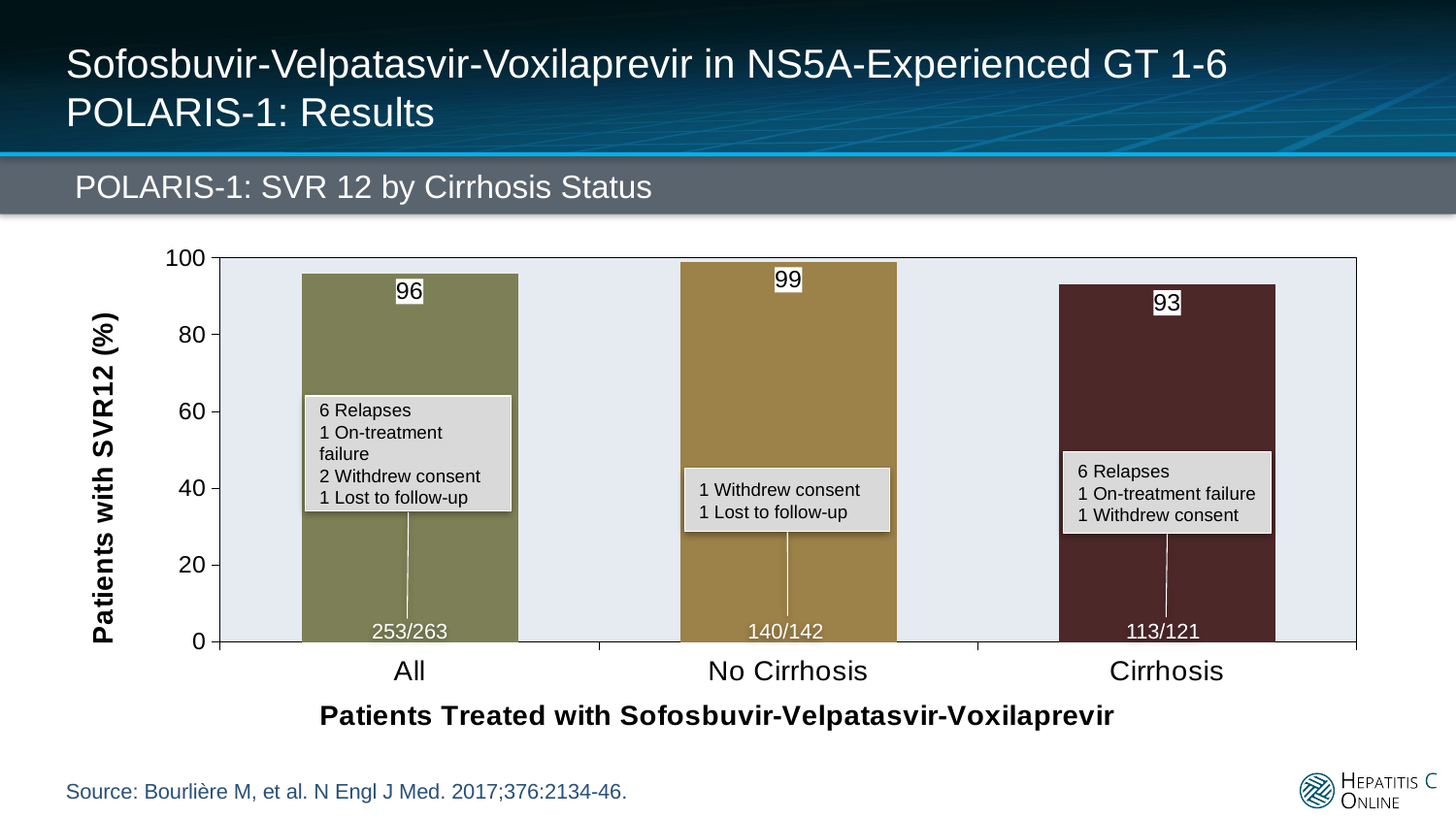
Which group has the lowest SVR12 rate? Cirrhosis What fraction of patients achieved SVR12 in the No Cirrhosis group? 140/142 What fraction of patients achieved SVR12 in the Cirrhosis group? 113/121 What type of chart is shown on the slide? Bar chart How many patient groups are shown on the x axis? 3 Which group has the highest SVR12 rate? No Cirrhosis Which group has a higher SVR12 rate, All or Cirrhosis? All What is the SVR12 rate for the All group? 96 What is the title of the chart? POLARIS-1: SVR 12 by Cirrhosis Status What is the difference in SVR12 rate between the No Cirrhosis and Cirrhosis groups? 6 What is the SVR12 rate for patients with Cirrhosis? 93 What is the SVR12 rate for patients with No Cirrhosis? 99